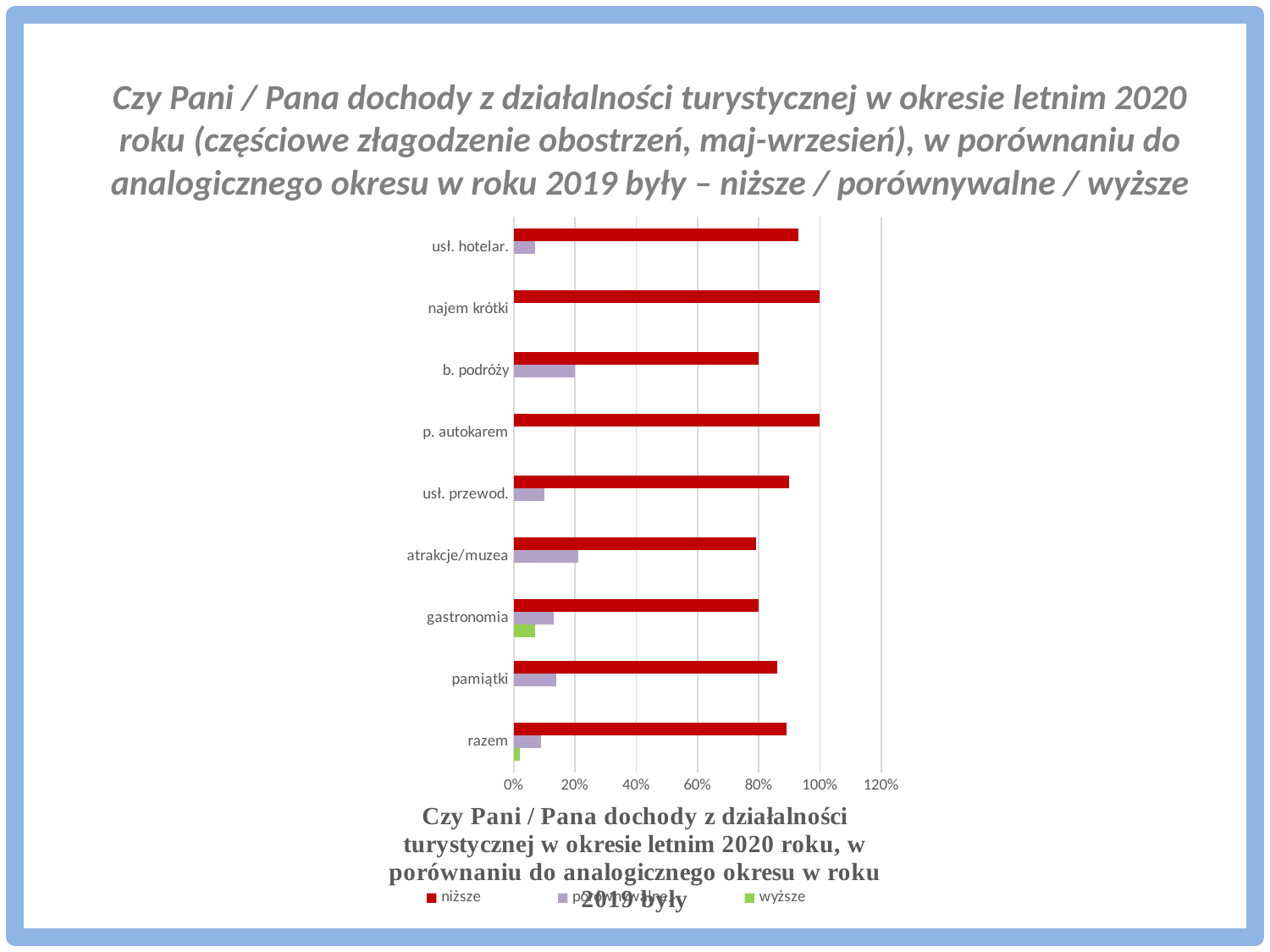
Is the value of 'niższe' for 'razem' greater or less than 80%? greater Which colour represents the 'wyższe' series in the legend? green How many series does the legend list? 3 Which has a larger 'porównywalne' value: 'b. podróży' or 'usł. hotelar.'? b. podróży What is the value of 'niższe' for 'najem krótki'? 100% How many categories are plotted on the y axis? 9 Which has a larger 'niższe' value: 'najem krótki' or 'b. podróży'? najem krótki Is the value of 'wyższe' for 'gastronomia' greater or less than 20%? less What type of chart is shown on the slide? bar chart Is the value of 'niższe' for 'usł. hotelar.' greater or less than 80%? greater What is the value of 'niższe' for 'p. autokarem'? 100%